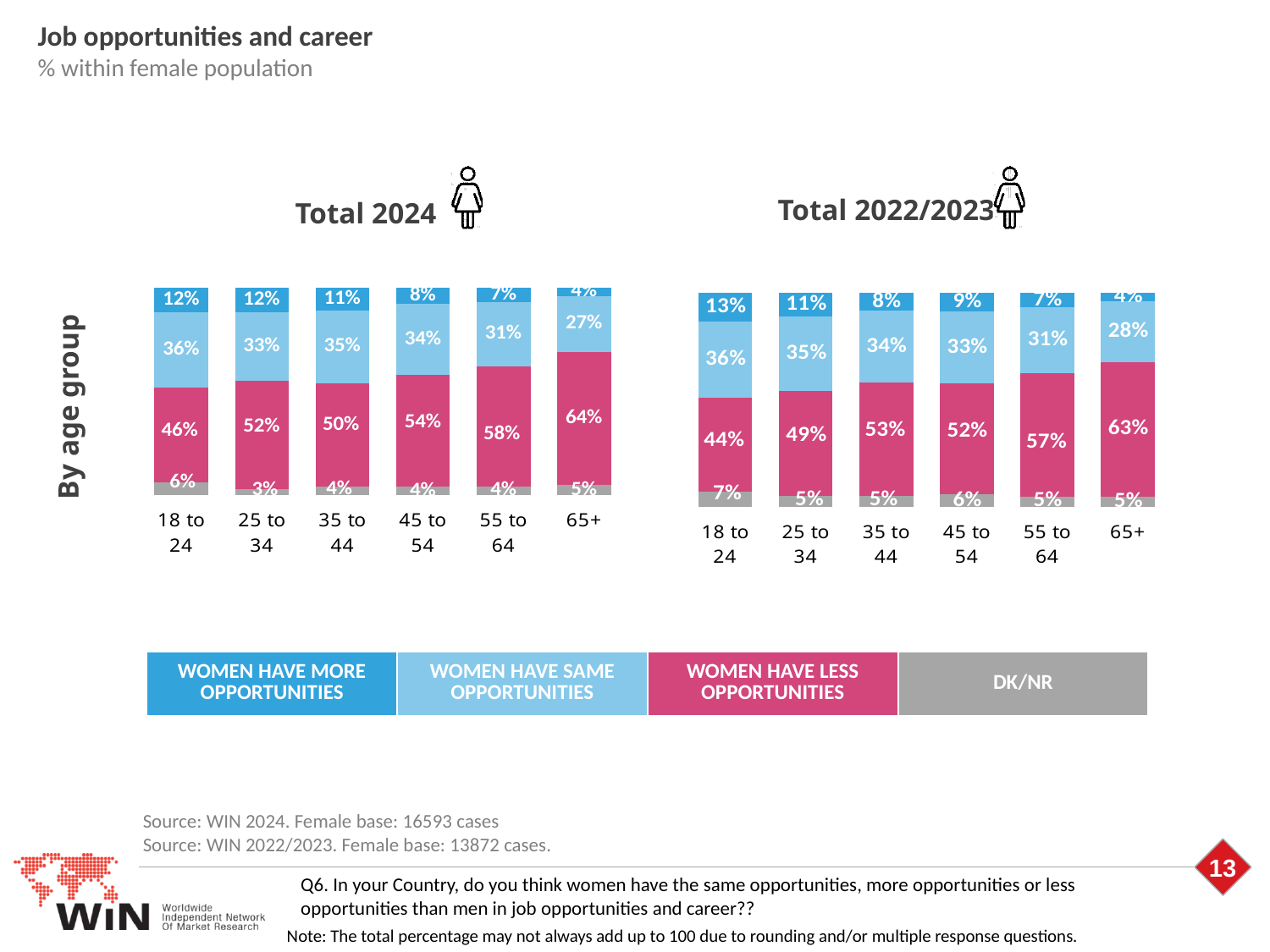
In the Total 2024 chart, which age group has the highest share saying women have less opportunities? 65+ In the Total 2024 chart, what is the difference between the 'women have less opportunities' share for 65+ and for 18 to 24? 18 percentage points In the Total 2022/2023 chart, which is larger: the 'women have same opportunities' share for 25 to 34 or for 55 to 64? 25 to 34 What type of chart is the Total 2022/2023 chart? Stacked bar chart In the Total 2022/2023 chart, what percentage of women aged 18 to 24 say women have more opportunities? 13% In the Total 2022/2023 chart, which age group has the lowest share saying women have more opportunities? 65+ In the Total 2022/2023 chart, what is the DK/NR share for the 45 to 54 age group? 6% How many age groups are shown in the Total 2024 chart? 6 In the Total 2024 chart, what percentage of women aged 65+ say women have less opportunities? 64% How many series does the legend list for the charts? 4 Which colour represents 'women have less opportunities' in the legend? Pink In the Total 2024 chart, does the 'women have less opportunities' share rise or fall from the 45 to 54 group to the 65+ group? Rise